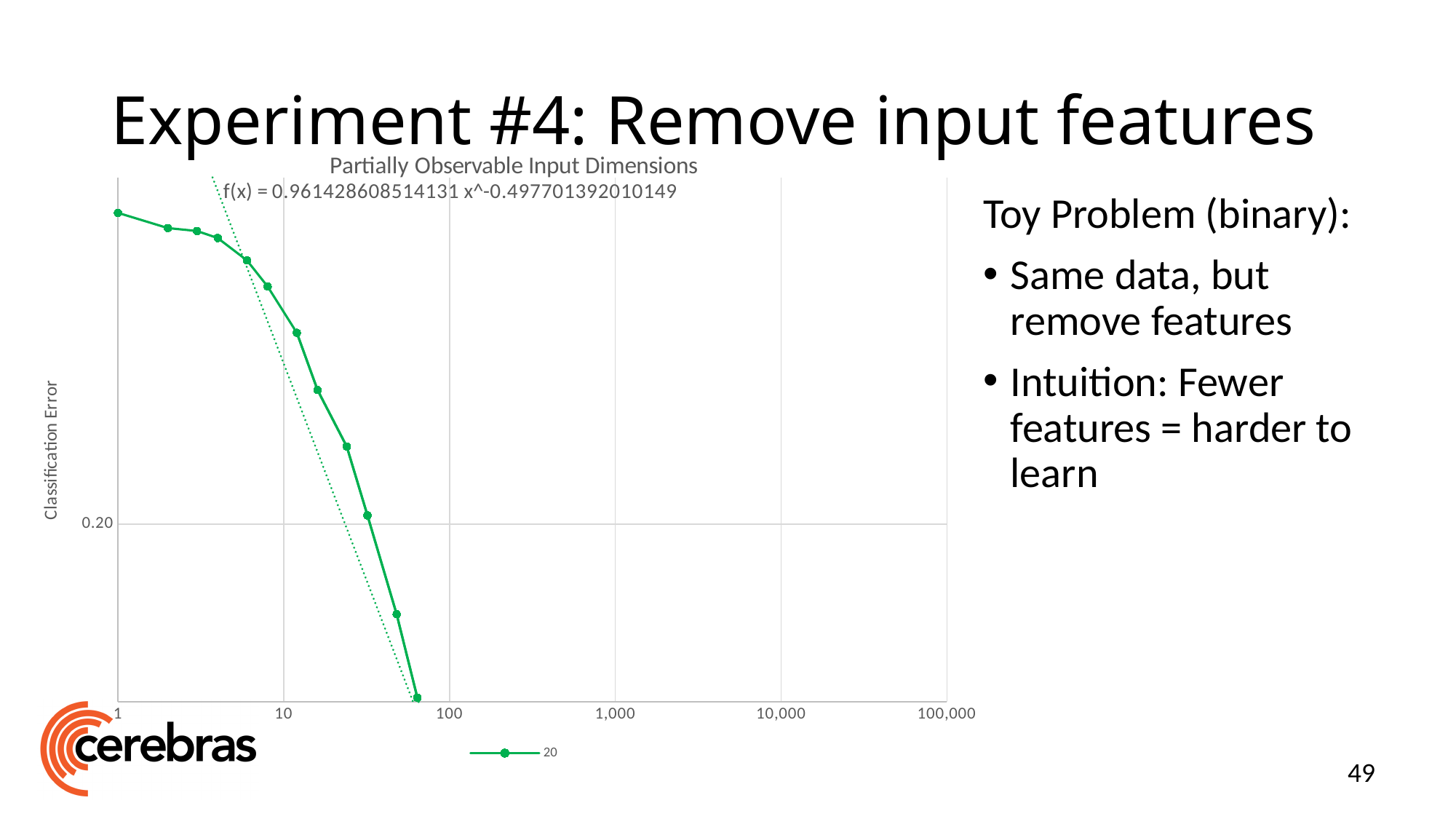
What is the title of the chart? Partially Observable Input Dimensions What kind of chart is shown on the slide? line chart Does the classification error rise or fall as the x-axis value increases? fall Is the classification error at x = 1 greater or less than 0.20? greater How many data points are plotted on the line? 12 How many series does the chart's legend list? 1 What is the label of the y axis of the chart? Classification Error Is the classification error at the rightmost data point greater or less than 0.20? less What is the largest value labelled on the x axis? 100,000